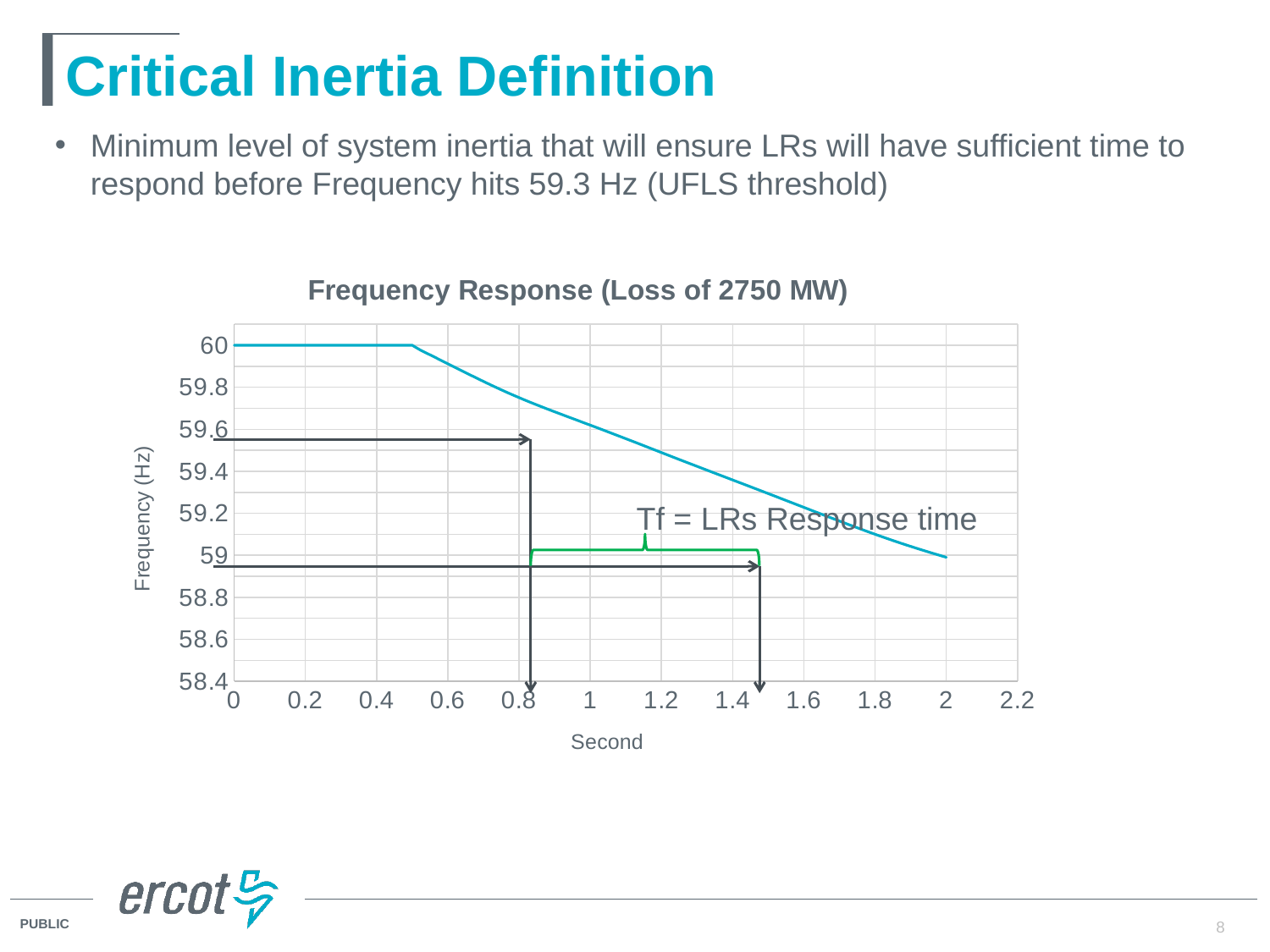
Which is larger, the frequency at 0.2 seconds or the frequency at 1.8 seconds? 0.2 seconds What is the highest frequency value reached by the line? 60 What is the frequency at 0.4 seconds? 60 What is the title of the chart? Frequency Response (Loss of 2750 MW) What is the label of the y axis of the chart? Frequency (Hz) Is the frequency at 0.6 seconds greater or less than 59.8? greater What is the frequency at 0 seconds? 60 Is the frequency at 1.4 seconds greater or less than 59.2? greater Is the frequency at 2 seconds greater or less than 59.2? less Does the frequency rise or fall along the x axis after 0.5 seconds? fall What type of chart is shown on the slide? line chart